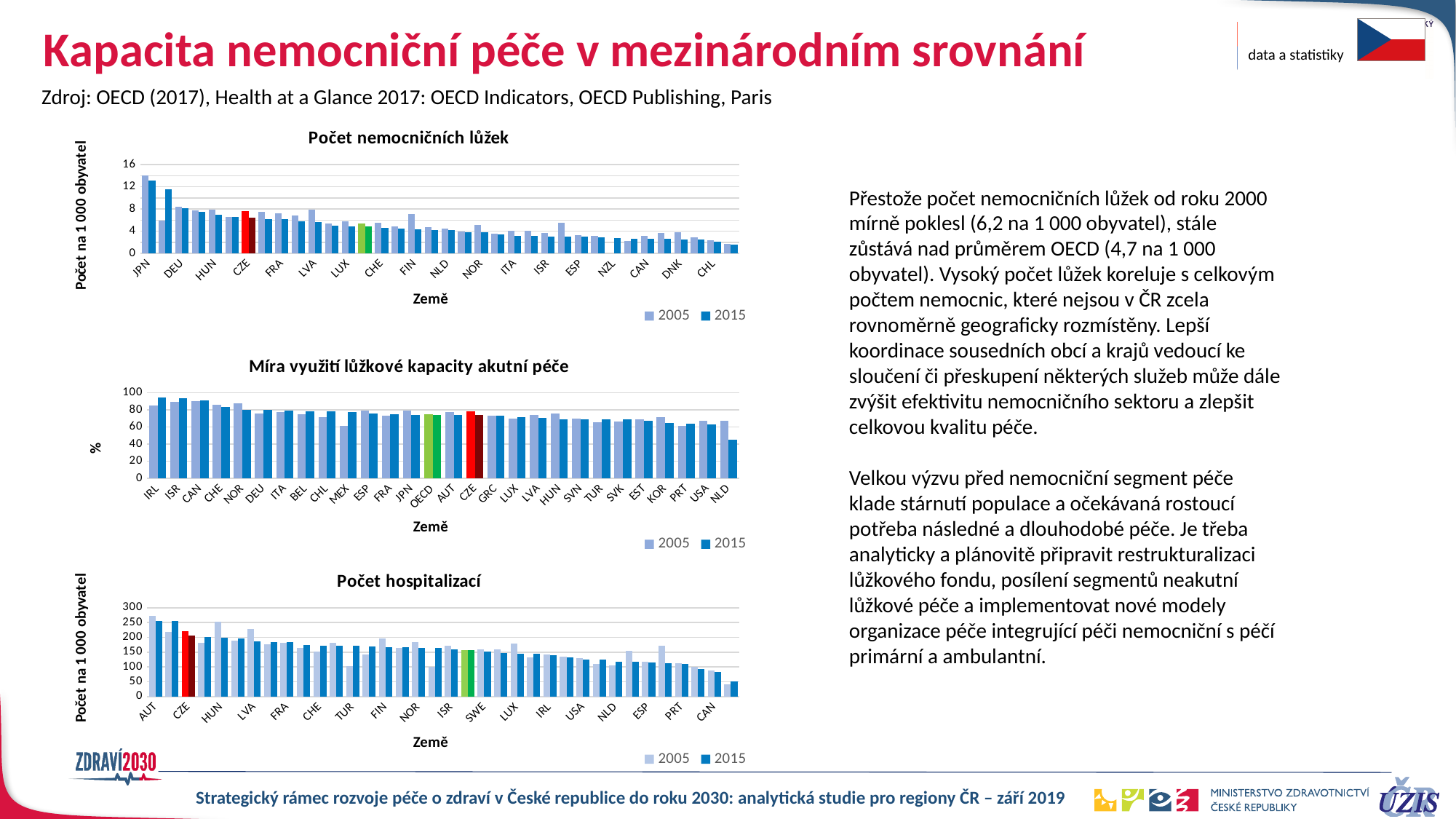
In the 'Počet nemocničních lůžek' chart, do the values rise or fall from left to right along the x axis? fall In the 'Počet nemocničních lůžek' chart, is the 2015 value for JPN greater or less than 12? greater In the 'Počet nemocničních lůžek' chart, is the 2015 value for CZE greater or less than 4? greater In the 'Počet hospitalizací' chart, is the 2015 value for CZE greater or less than 250? less In the 'Počet hospitalizací' chart, which country has the highest value? AUT In the 'Míra využití lůžkové kapacity akutní péče' chart, which is larger, the 2015 value for IRL or for NLD? IRL What are the two legend entries of the 'Počet hospitalizací' chart? 2005 and 2015 In the 'Míra využití lůžkové kapacity akutní péče' chart, which country has the lowest 2015 value? NLD What kind of chart is the 'Počet nemocničních lůžek' chart? bar chart In the 'Počet nemocničních lůžek' chart, which country has the highest value? JPN How many series does the legend of the 'Míra využití lůžkové kapacity akutní péče' chart list? 2